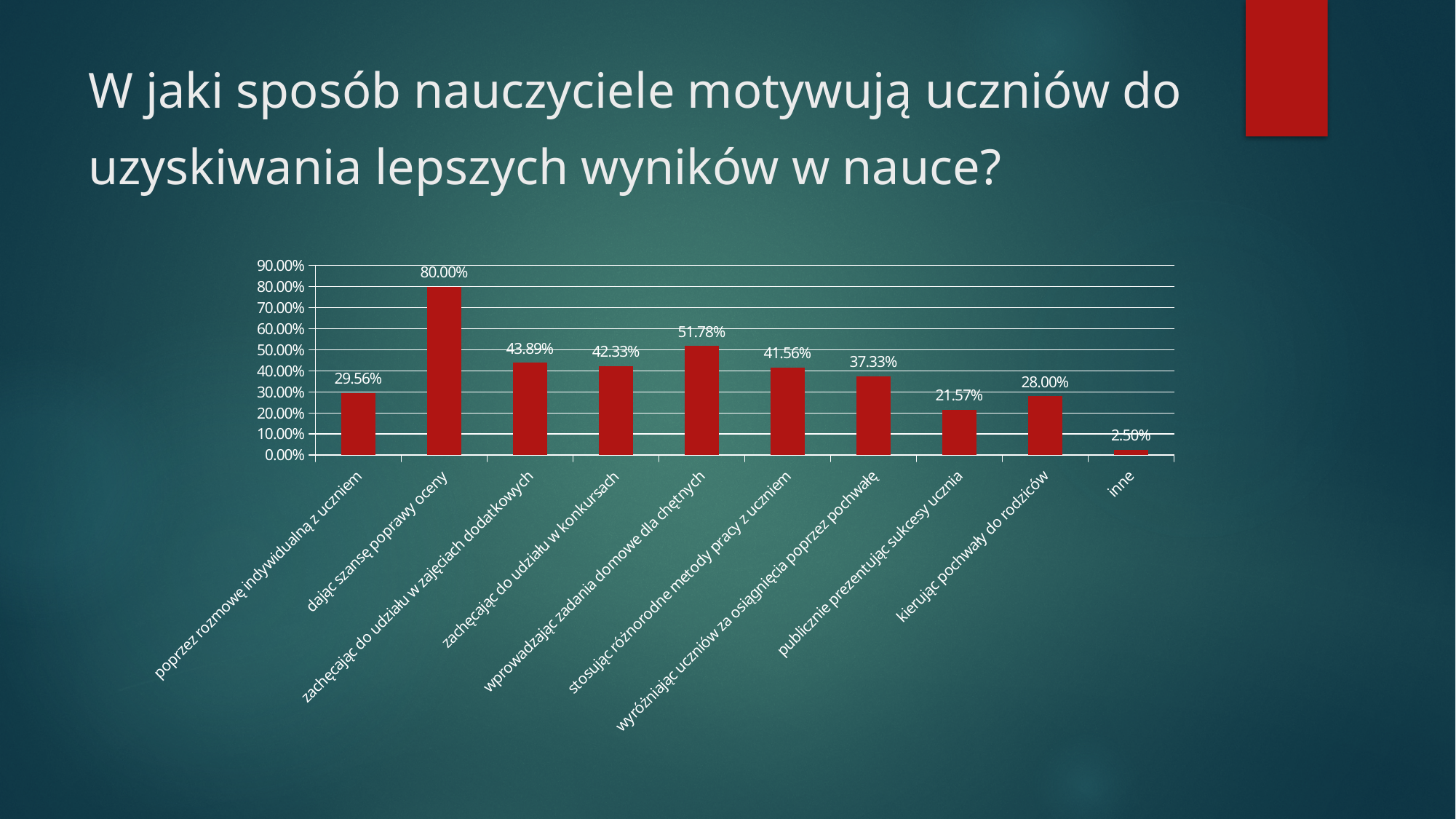
Which category has the highest value? dając szansę poprawy oceny Is the value for "publicznie prezentując sukcesy ucznia" greater or less than 30.00%? less Which category has the lowest value? inne How many categories are shown on the x axis? 10 What is the value for "kierując pochwały do rodziców"? 28.00% What is the value for "dając szansę poprawy oceny"? 80.00% Which is larger: the value for "zachęcając do udziału w zajęciach dodatkowych" or the value for "wyróżniając uczniów za osiągnięcia poprzez pochwałę"? zachęcając do udziału w zajęciach dodatkowych What kind of chart is shown on the slide? bar chart What is the difference between the values for "dając szansę poprawy oceny" and "wprowadzając zadania domowe dla chętnych"? 28.22% What colour are the bars in the chart? red What is the value for "inne"? 2.50% What is the value for "wprowadzając zadania domowe dla chętnych"? 51.78%